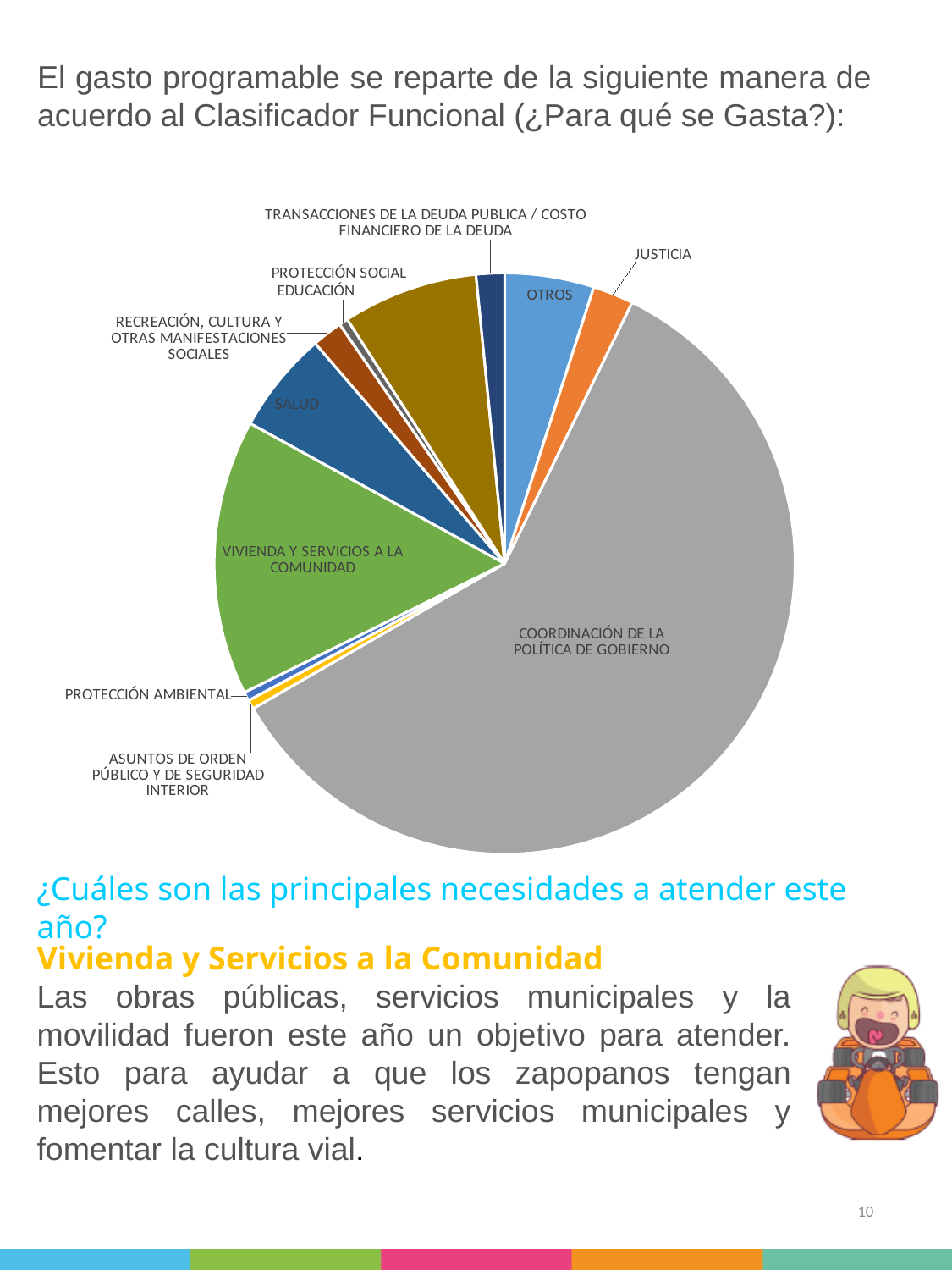
Which category has the largest slice of the pie? COORDINACIÓN DE LA POLÍTICA DE GOBIERNO Which category has the second largest slice of the pie? VIVIENDA Y SERVICIOS A LA COMUNIDAD What colour is the VIVIENDA Y SERVICIOS A LA COMUNIDAD slice? Green What kind of chart is shown on the slide? Pie chart What colour is the COORDINACIÓN DE LA POLÍTICA DE GOBIERNO slice? Gray Which slice is larger, SALUD or JUSTICIA? SALUD Which slice is larger, PROTECCIÓN SOCIAL or OTROS? PROTECCIÓN SOCIAL Which slice is larger, COORDINACIÓN DE LA POLÍTICA DE GOBIERNO or VIVIENDA Y SERVICIOS A LA COMUNIDAD? COORDINACIÓN DE LA POLÍTICA DE GOBIERNO How many categories (slices) are labelled in the pie chart? 11